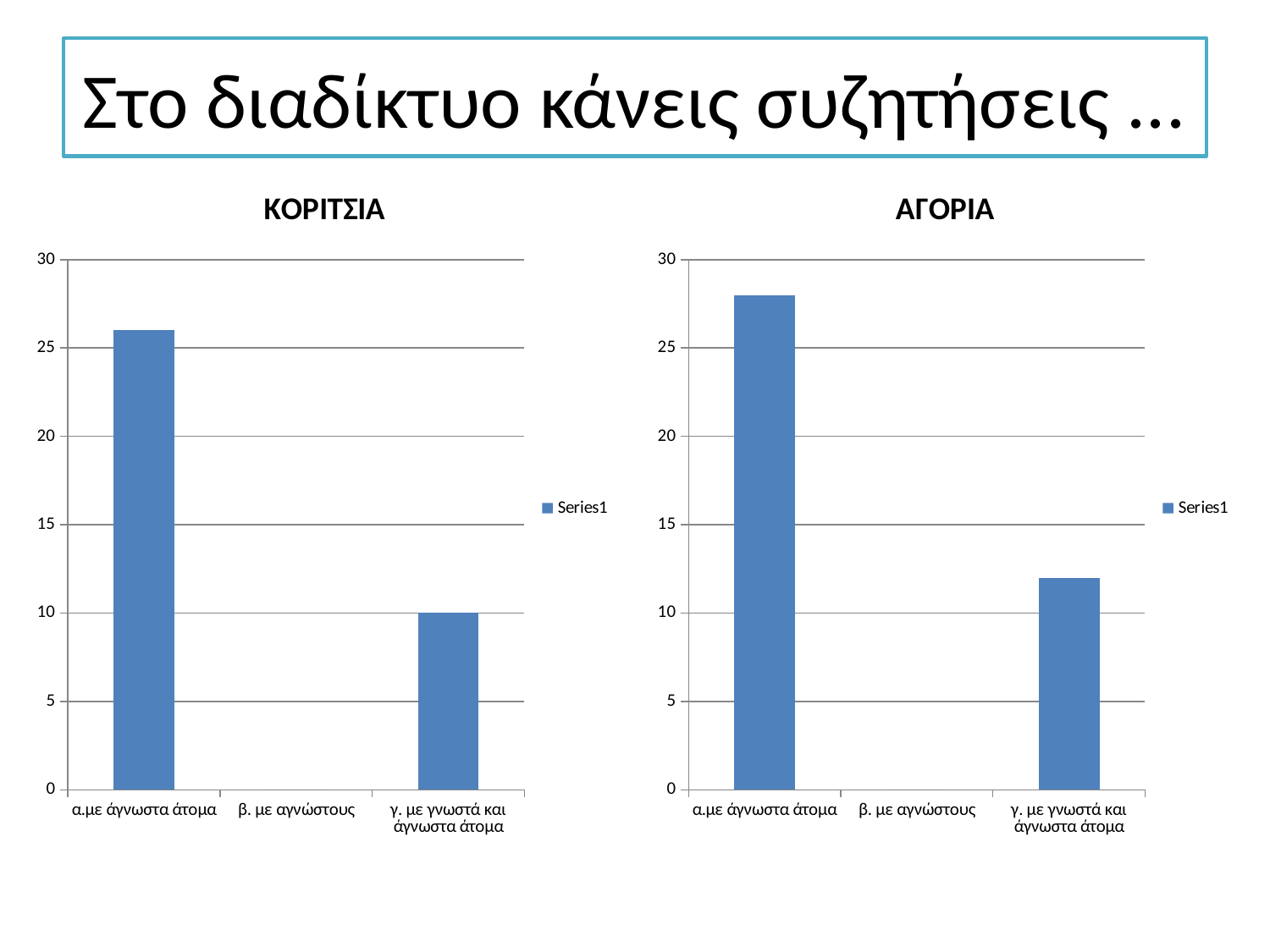
How many series does the legend of the ΚΟΡΙΤΣΙΑ chart list? 1 In the ΚΟΡΙΤΣΙΑ chart, which category has the highest value? α.με άγνωστα άτομα In the ΑΓΟΡΙΑ chart, which category has the highest value? α.με άγνωστα άτομα In the ΑΓΟΡΙΑ chart, is the value for 'γ. με γνωστά και άγνωστα άτομα' greater or less than 15? less In the ΑΓΟΡΙΑ chart, is the value for 'α.με άγνωστα άτομα' greater or less than 25? greater What is the title of the chart on the right side of the slide? ΑΓΟΡΙΑ In the ΚΟΡΙΤΣΙΑ chart, is the value for 'α.με άγνωστα άτομα' greater or less than 25? greater In the ΑΓΟΡΙΑ chart, which category has the lowest value? β. με αγνώστους Which is larger: the value for 'α.με άγνωστα άτομα' in the ΚΟΡΙΤΣΙΑ chart or in the ΑΓΟΡΙΑ chart? ΑΓΟΡΙΑ What kind of chart is the ΚΟΡΙΤΣΙΑ chart on the left? bar chart How many categories are shown on the x axis of the ΑΓΟΡΙΑ chart? 3 In the ΚΟΡΙΤΣΙΑ chart, what is the value for 'γ. με γνωστά και άγνωστα άτομα'? 10